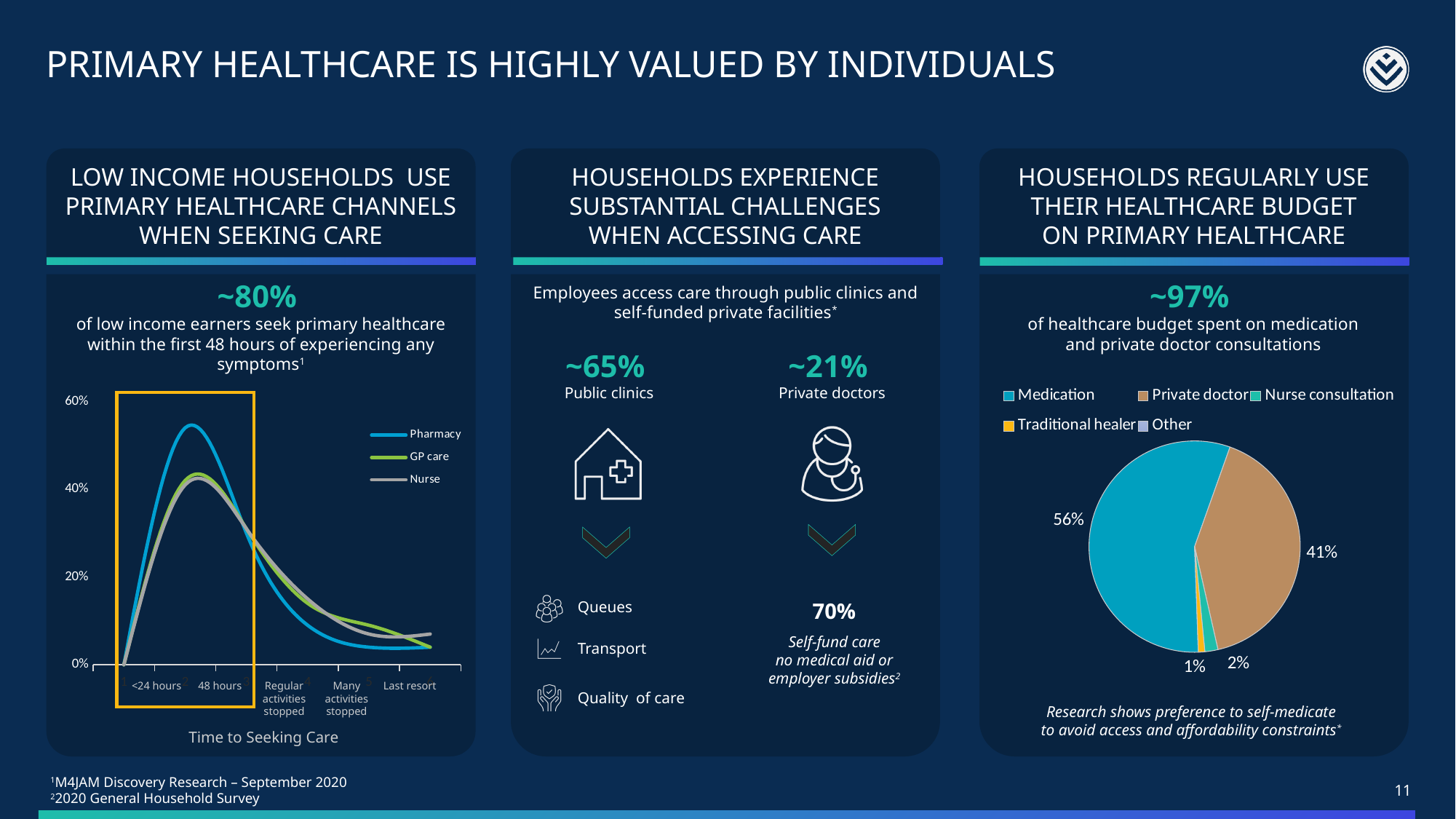
What kind of chart is shown in the right-hand panel about healthcare budget? Pie chart In the pie chart on the right, which is larger: the Medication slice or the Private doctor slice? Medication In the 'Time to Seeking Care' chart, do the lines rise or fall from the 48 hours point to the Last resort point? Fall How many series does the legend of the 'Time to Seeking Care' chart list? 3 In the pie chart on the right, which category has the largest slice? Medication What kind of chart is shown in the left-hand panel titled 'Time to Seeking Care'? Line chart How many categories does the legend of the pie chart on the right list? 5 In the 'Time to Seeking Care' chart, is the peak value of the Pharmacy line greater or less than 40%? greater In the pie chart on the right, what share of the healthcare budget is spent on Medication? 56% In the 'Time to Seeking Care' chart, which series reaches the highest peak? Pharmacy In the pie chart on the right, what share of the healthcare budget is spent on Private doctor? 41% In the pie chart on the right, what is the difference in percentage points between the Medication and Private doctor slices? 15 percentage points